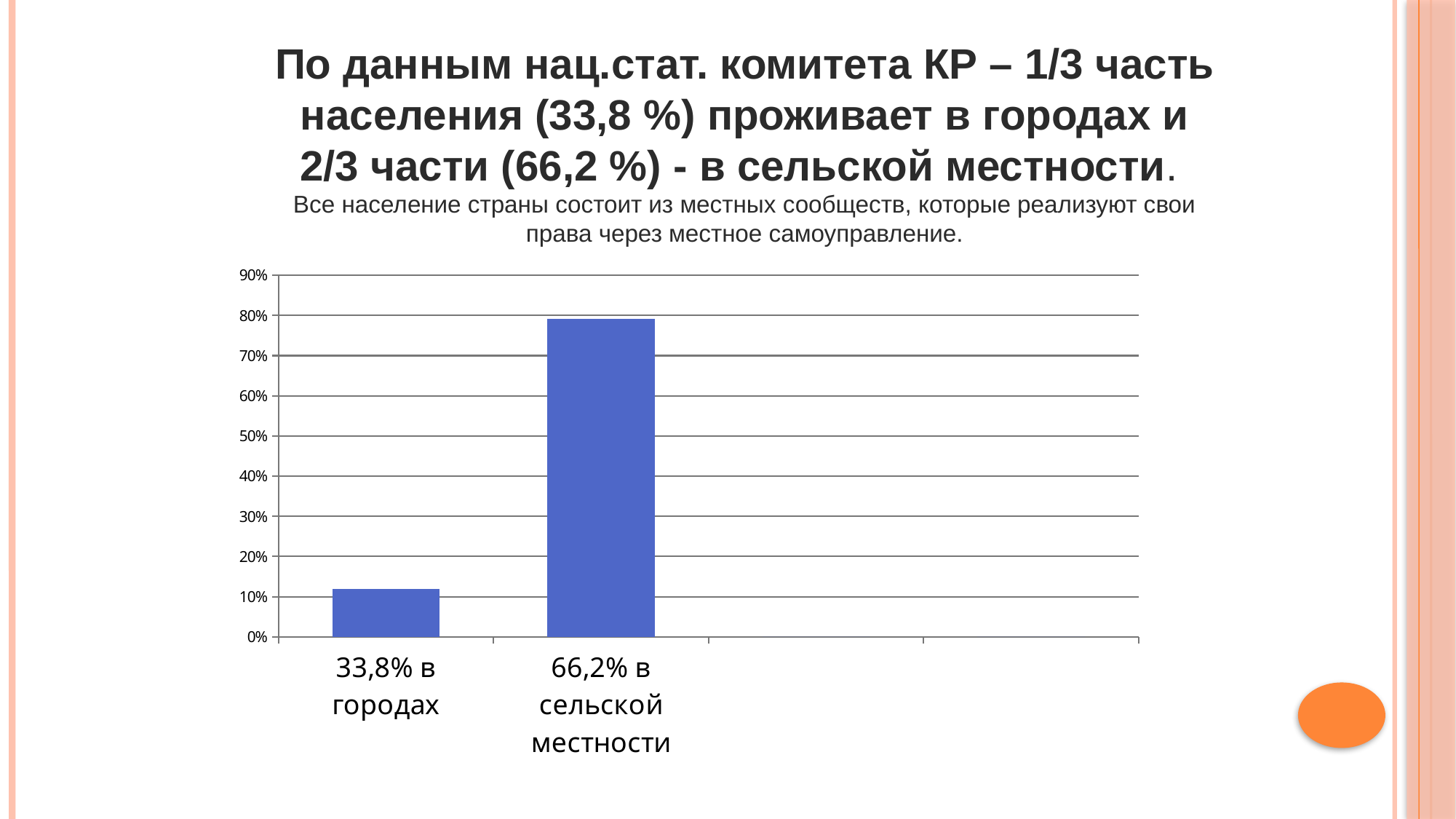
What is the highest value shown on the vertical axis of the chart? 90% Which category has the highest bar in the chart? 66,2% в сельской местности Do the bar values rise or fall from left to right along the x axis? rise How many bars does the chart show? 2 Is the bar for "33,8% в городах" greater or less than 20%? less What colour are the bars in the chart? blue Which bar is taller: "33,8% в городах" or "66,2% в сельской местности"? 66,2% в сельской местности Is the bar for "66,2% в сельской местности" greater or less than 70%? greater Which category has the lowest bar in the chart? 33,8% в городах What kind of chart is shown on the slide? bar chart Is the bar for "33,8% в городах" greater or less than 10%? greater